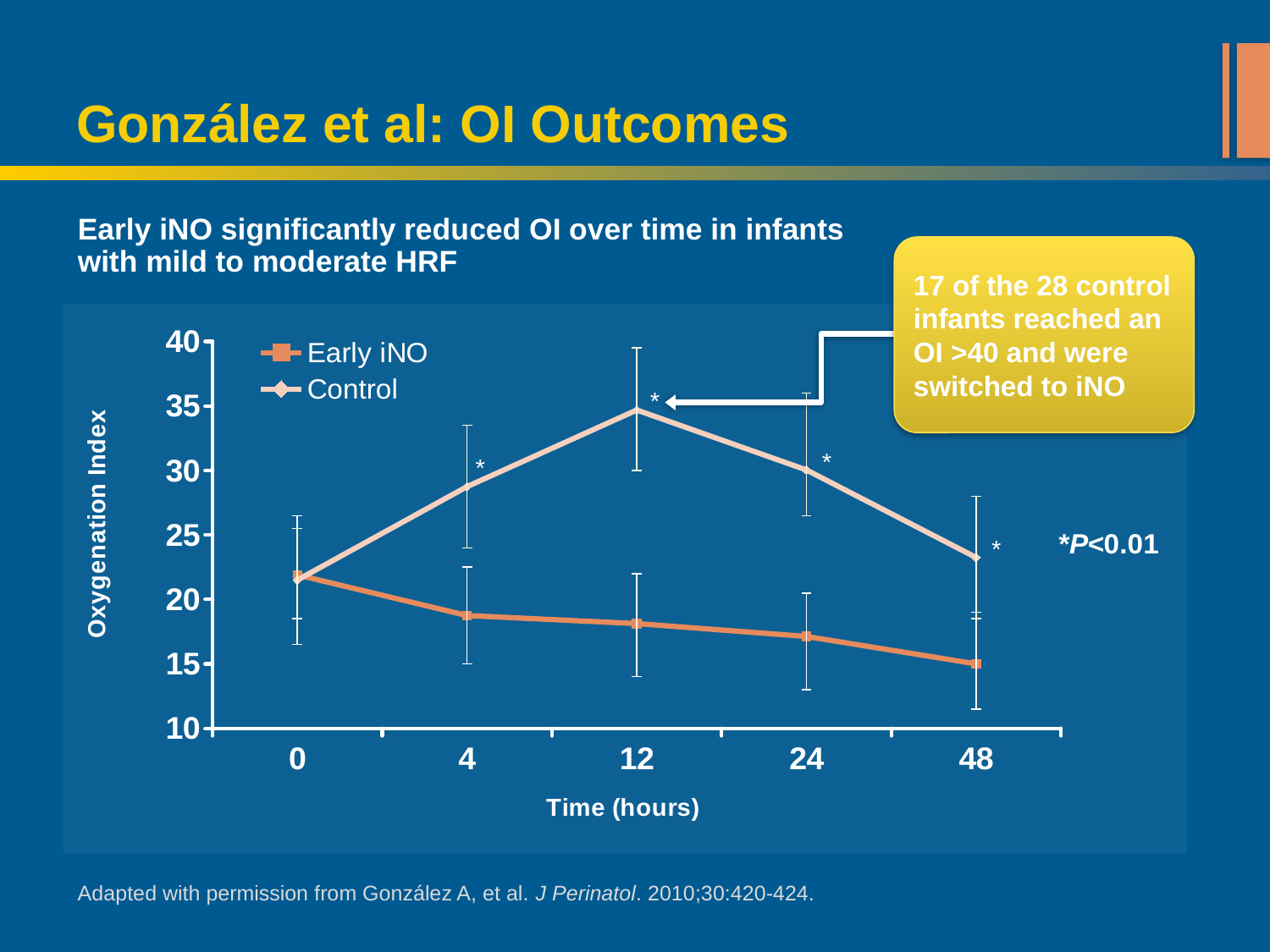
At which time point is the Early iNO series at its lowest value? 48 hours Is the Control value at 48 hours greater or less than 25? less What are the two series named in the legend? Early iNO and Control At 24 hours, which series has the higher Oxygenation Index, Early iNO or Control? Control Is the Control value at 12 hours greater or less than 30? greater Is the Early iNO value at 4 hours greater or less than 20? less How many series does the legend list? 2 At which time point does the Control series reach its highest Oxygenation Index? 12 hours How many time points are plotted along the x axis? 5 What kind of chart is shown on the slide? Line chart What is the label on the y axis of the chart? Oxygenation Index Does the Early iNO series rise or fall from 0 to 48 hours? Fall